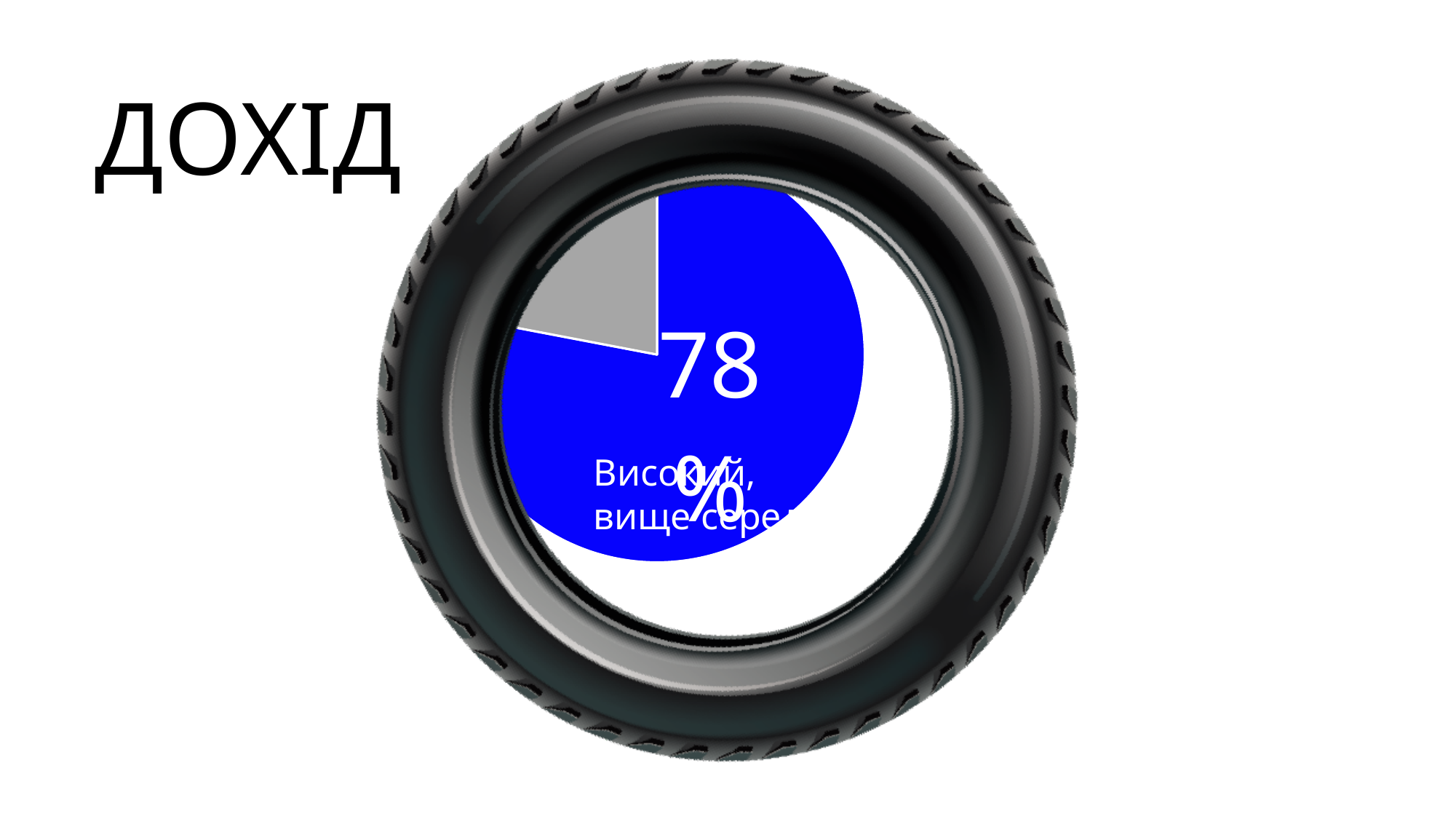
What kind of chart is shown on the slide? pie chart What percentage is printed on the blue slice of the pie chart? 78% Is the blue slice of the pie chart greater or less than 50% of the pie? greater How many slices does the pie chart have? 2 What colour is the largest slice of the pie chart? blue What is the title shown on the slide above the pie chart? ДОХІД Is the grey slice of the pie chart greater or less than 50% of the pie? less Which slice of the pie chart is larger, the blue one or the grey one? the blue one